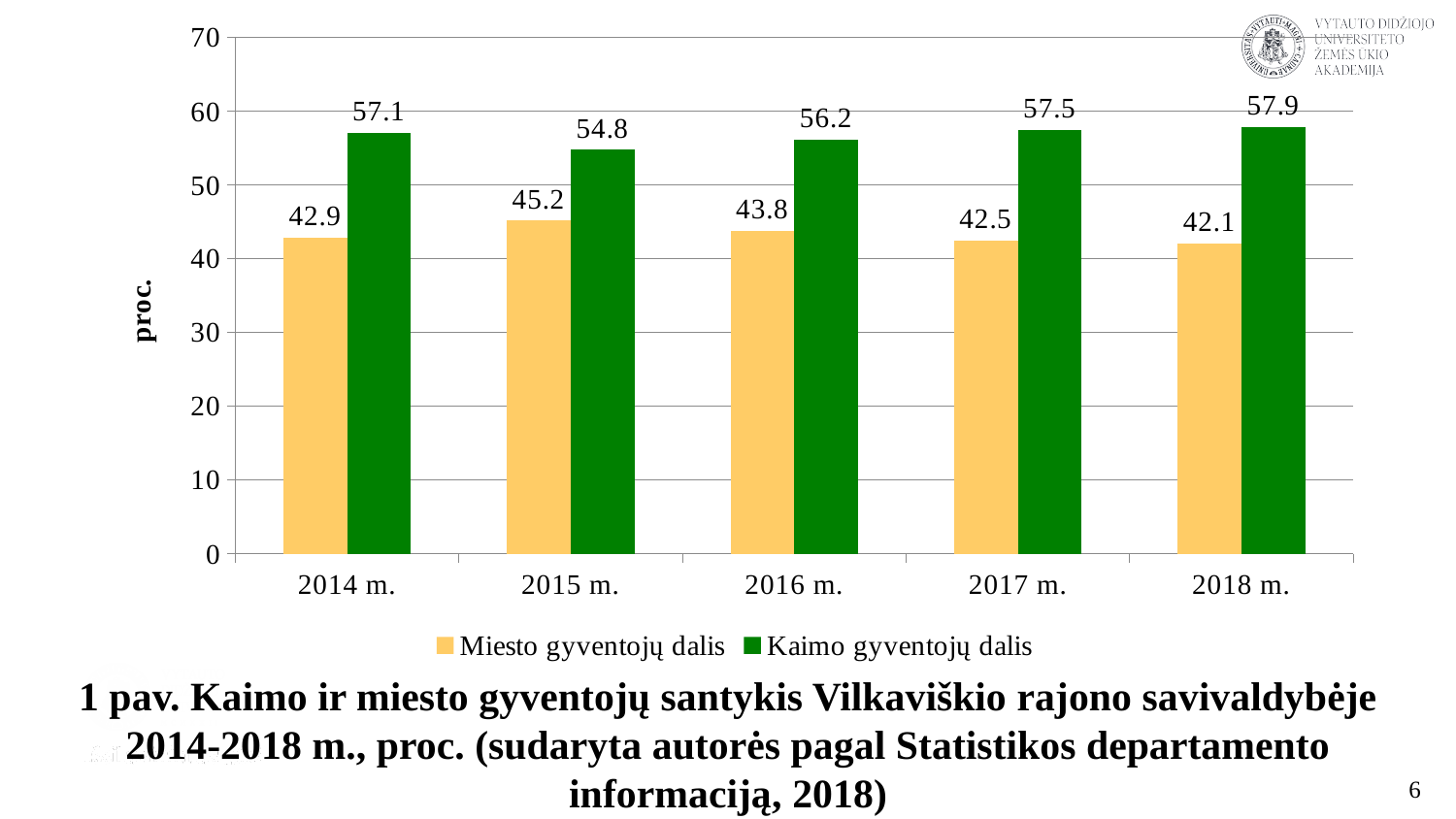
What is the value of Kaimo gyventojų dalis for 2015 m.? 54.8 What is the value of Miesto gyventojų dalis for 2014 m.? 42.9 What is the label of the y axis? proc. How many years are shown on the x axis? 5 Is the value of Miesto gyventojų dalis for 2018 m. greater or less than 50? less What kind of chart is shown on the slide? bar chart How many series does the legend list? 2 In which year is Miesto gyventojų dalis highest? 2015 m. In which year is Kaimo gyventojų dalis lowest? 2015 m. Which is larger in 2016 m., Miesto gyventojų dalis or Kaimo gyventojų dalis? Kaimo gyventojų dalis What is the difference between Kaimo gyventojų dalis and Miesto gyventojų dalis in 2017 m.? 15 What is the value of Kaimo gyventojų dalis for 2018 m.? 57.9